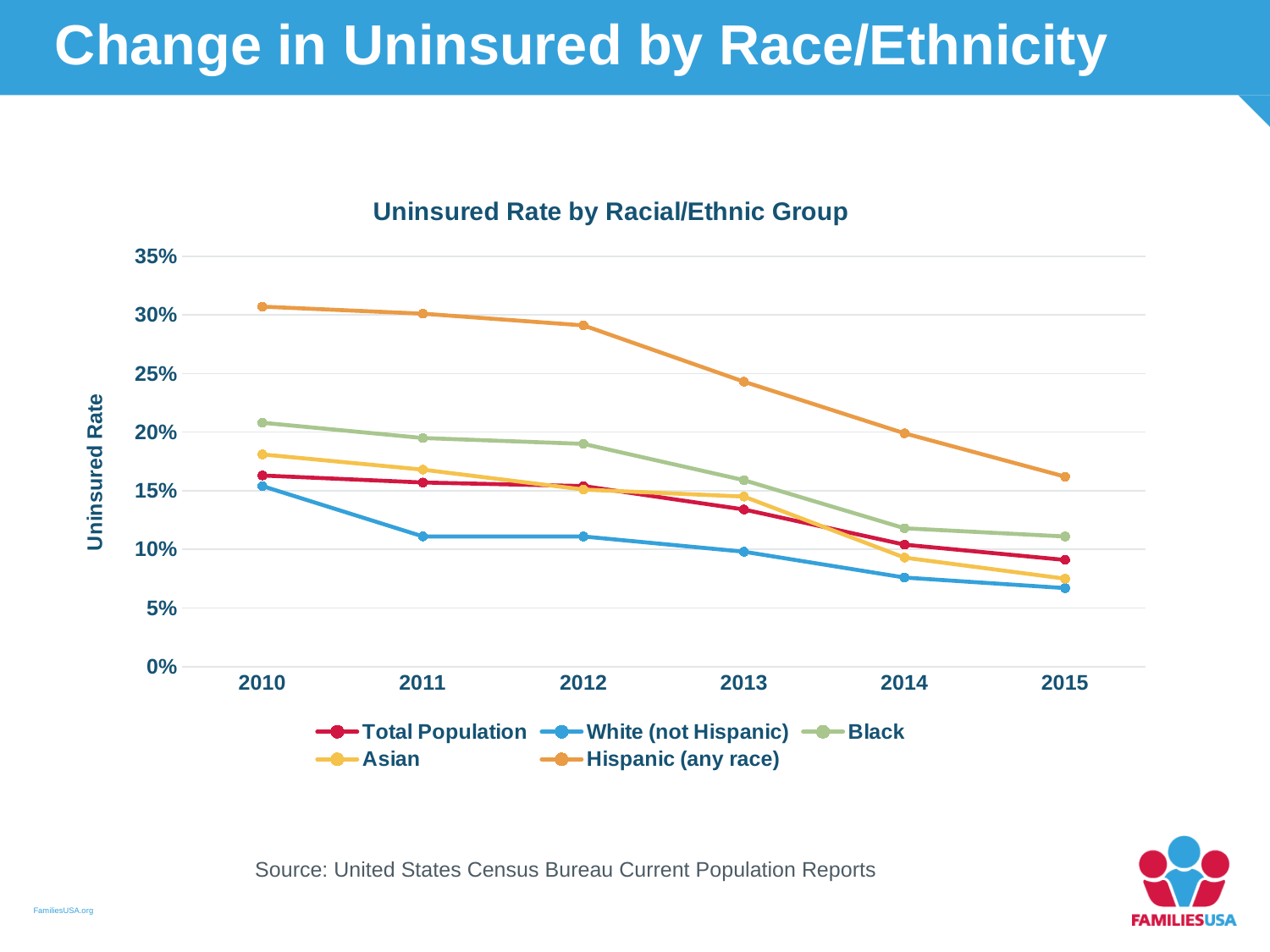
What is the label on the y axis of the chart? Uninsured Rate What is the title of the chart? Uninsured Rate by Racial/Ethnic Group Is the uninsured rate for White (not Hispanic) in 2015 greater or less than 10%? less Which group had the lowest uninsured rate in 2015? White (not Hispanic) Which group had the highest uninsured rate in 2010? Hispanic (any race) What kind of chart is shown on the slide? Line chart How many series does the legend list? 5 How many years are plotted along the x axis? 6 In 2014, which group had a higher uninsured rate, Black or Asian? Black Does the uninsured rate for Hispanic (any race) rise or fall from 2010 to 2015? Fall Is the uninsured rate for Asian in 2015 greater or less than 10%? less Is the uninsured rate for Hispanic (any race) in 2010 greater or less than 25%? greater